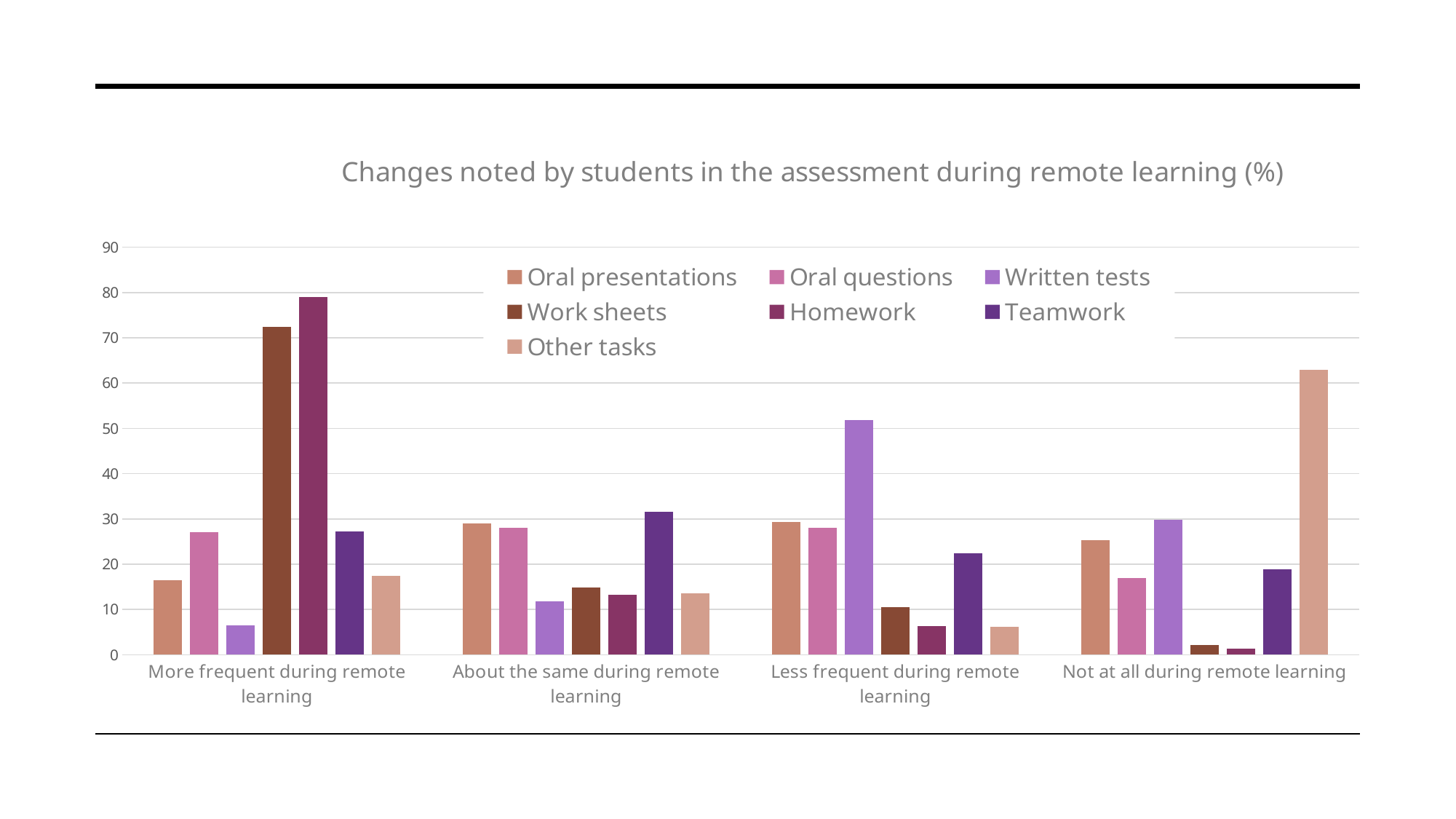
How many categories are shown along the x axis? 4 What kind of chart is shown on the slide? bar chart Is the value for Written tests in 'Less frequent during remote learning' greater or less than 40? greater Which series has the highest value in the 'Less frequent during remote learning' category? Written tests What is the title of the chart? Changes noted by students in the assessment during remote learning (%) Which series has the highest value in the 'More frequent during remote learning' category? Homework Which series has the lowest value in the 'More frequent during remote learning' category? Written tests How many series does the legend list? 7 In the 'About the same during remote learning' category, which is larger: Teamwork or Written tests? Teamwork Is the value for Homework in 'More frequent during remote learning' greater or less than 70? greater Is the value for Other tasks in 'Not at all during remote learning' greater or less than 60? greater Which series has the highest value in the 'Not at all during remote learning' category? Other tasks